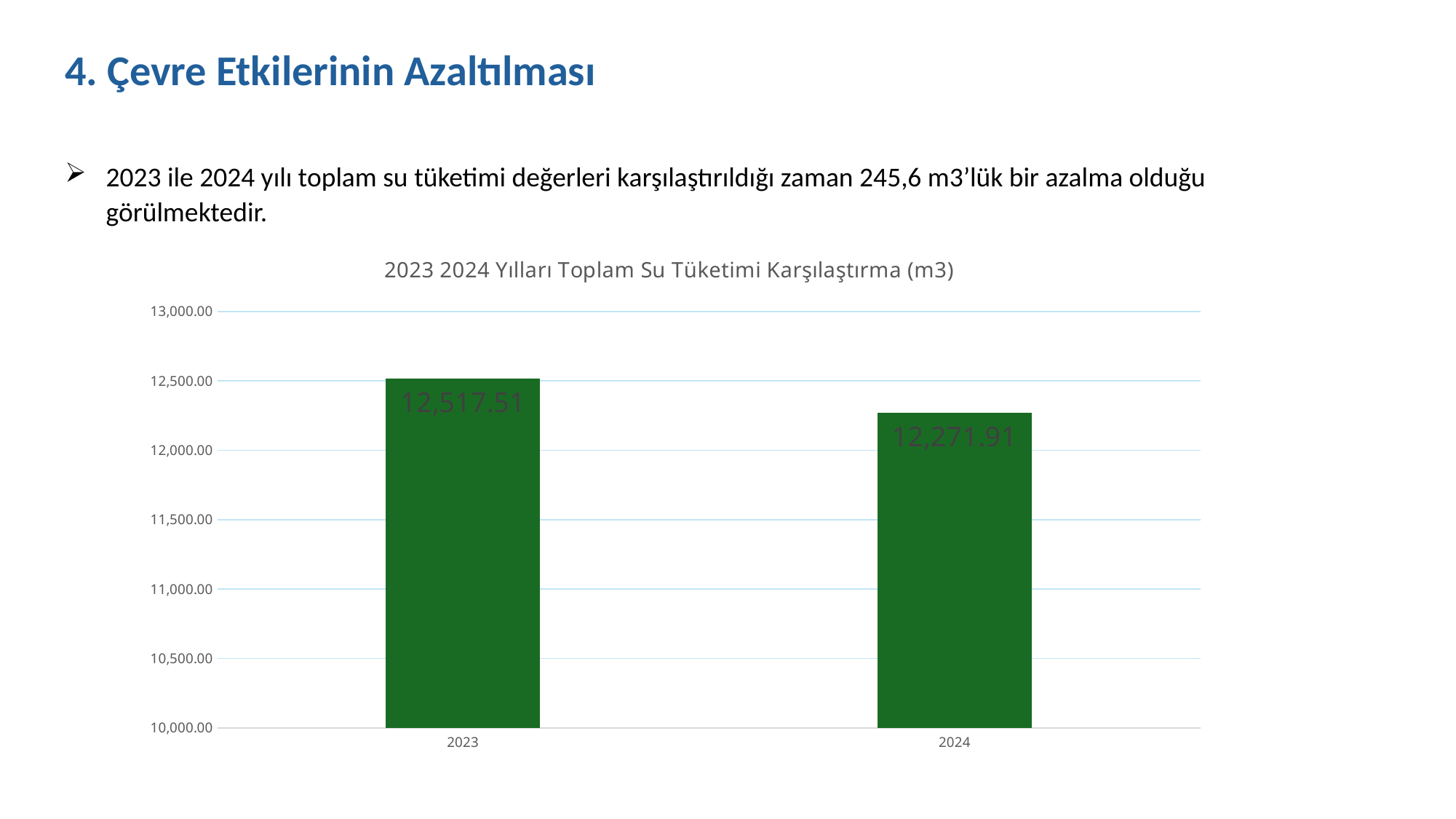
What type of chart is shown on the slide? Bar chart Do the values rise or fall from 2023 to 2024? fall What is the title of the chart? 2023 2024 Yılları Toplam Su Tüketimi Karşılaştırma (m3) How many bars are plotted in the chart? 2 Is the value for 2023 larger or smaller than the value for 2024? larger Which year has the lower total water consumption? 2024 What is the total water consumption value shown for 2024? 12,271.91 What is the difference between the 2023 and 2024 water consumption values? 245.60 Is the value for 2023 greater or less than 12,000.00? greater Which year has the higher total water consumption? 2023 Is the value for 2024 greater or less than 12,500.00? less What is the total water consumption value shown for 2023? 12,517.51